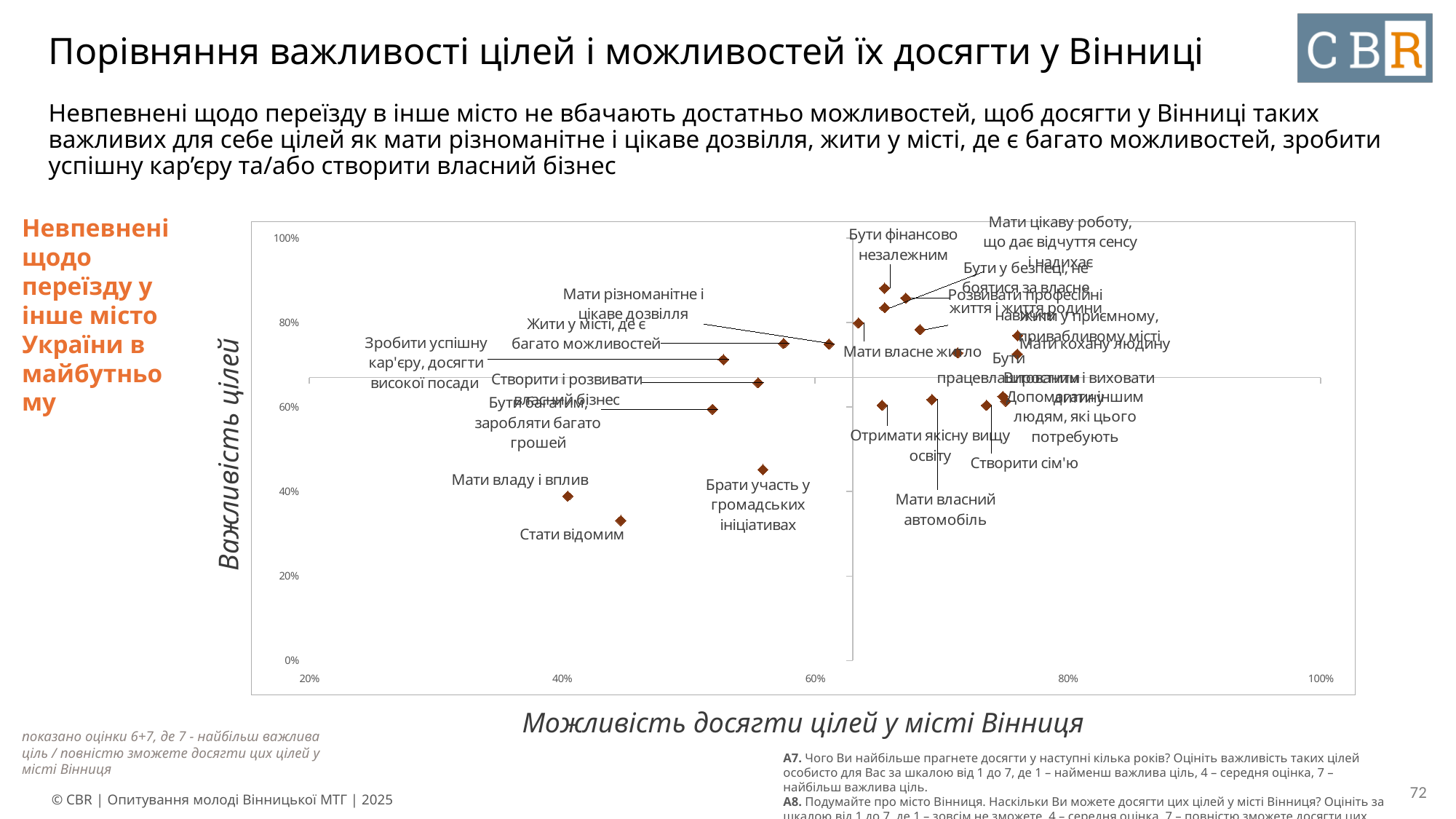
What kind of chart is shown on the slide? scatter chart Is the importance value for 'Стати відомим' greater or less than 40%? less Which goal has the lowest possibility of achievement (leftmost on the horizontal axis)? Мати владу і вплив Which goal has the higher importance: 'Стати відомим' or 'Бути фінансово незалежним'? Бути фінансово незалежним Which goal has the highest importance (highest position on the vertical axis)? Бути фінансово незалежним Is the importance value for 'Брати участь у громадських ініціативах' greater or less than 60%? less Is the possibility value (horizontal axis) for 'Зробити успішну кар'єру, досягти високої посади' greater or less than 60%? less Which goal has the lowest importance (lowest position on the vertical axis)? Стати відомим What is the title of the horizontal axis of the chart? Можливість досягти цілей у місті Вінниця What is the title of the vertical axis of the chart? Важливість цілей